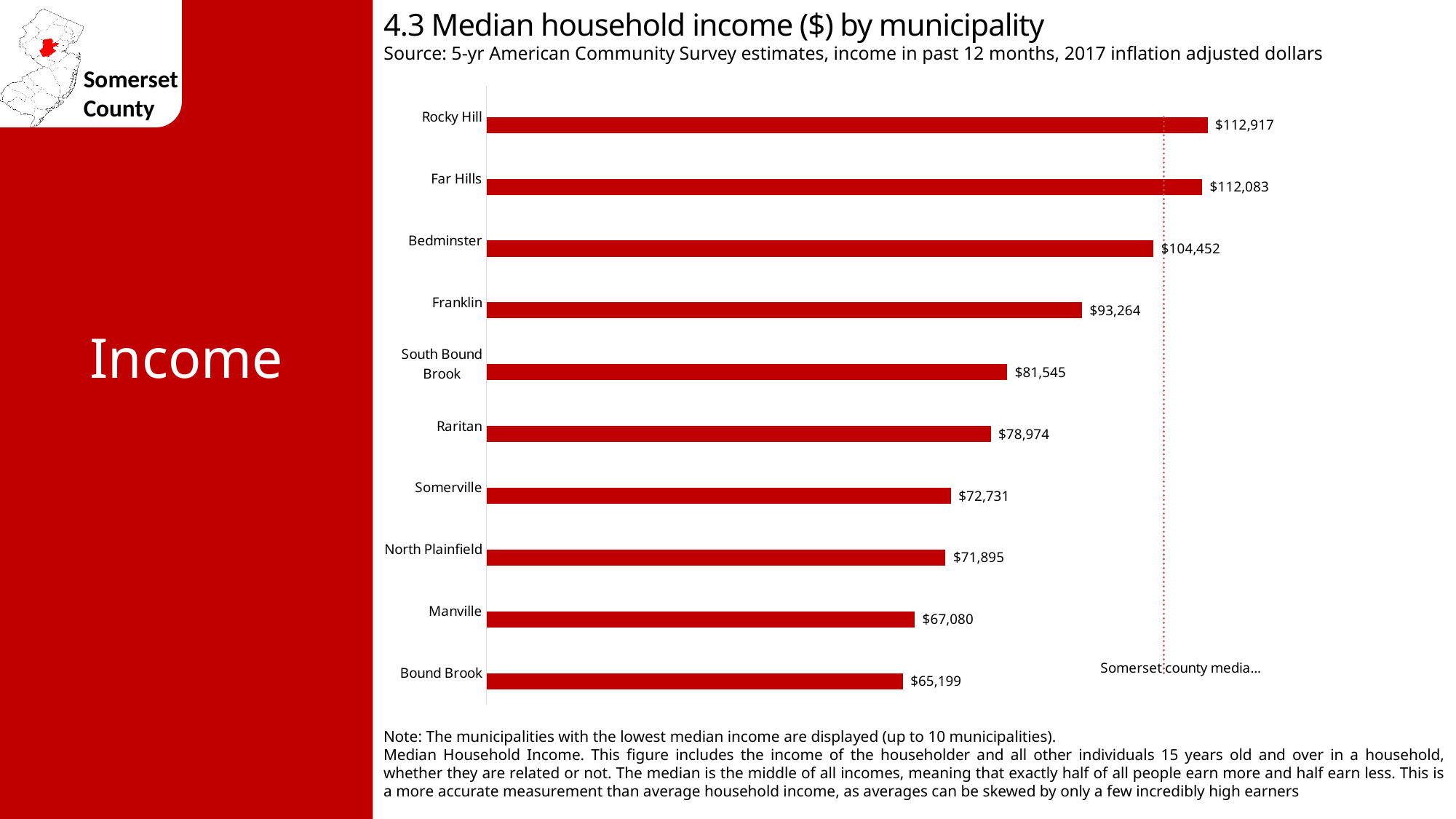
What is the median household income for Bedminster? $104,452 How many municipalities are shown on the chart? 10 What is the difference between the median household income of Franklin and Somerville? $20,533 What is the difference between the median household income of Rocky Hill and Bound Brook? $47,718 Which municipality has the highest median household income shown on the chart? Rocky Hill What is the title of the chart? 4.3 Median household income ($) by municipality What is the median household income for Rocky Hill? $112,917 Which has a higher median household income, Raritan or North Plainfield? Raritan What is the median household income for Manville? $67,080 What is the median household income for South Bound Brook? $81,545 What type of chart is used to show median household income by municipality? Bar chart Which municipality has the lowest median household income shown on the chart? Bound Brook